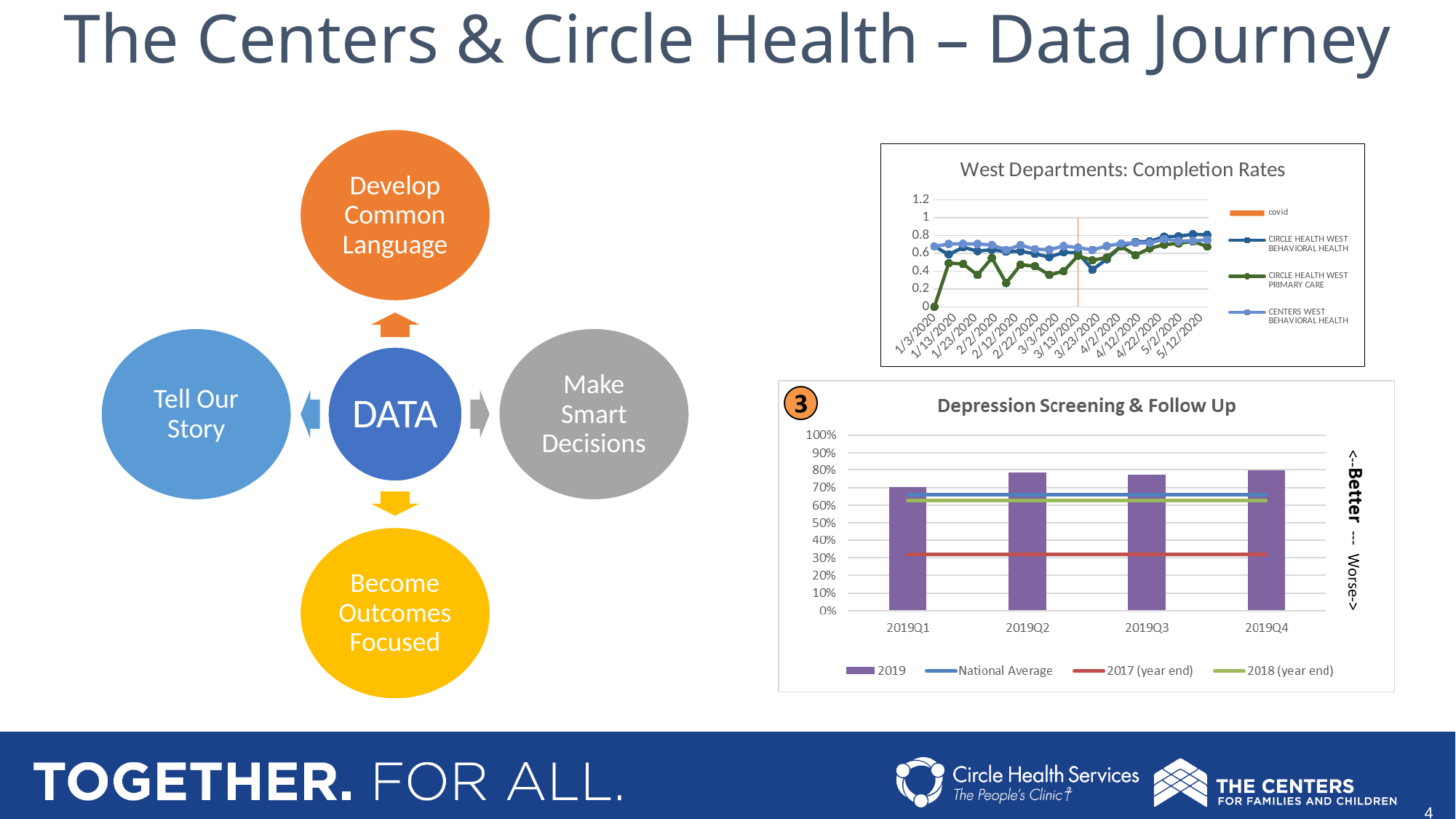
In the 'Depression Screening & Follow Up' chart, what colour are the 2019 bars? purple In the 'West Departments: Completion Rates' chart, what is the value for Circle Health West Primary Care on 1/3/2020? 0 In the 'Depression Screening & Follow Up' chart, how many quarters are shown on the x axis? 4 In the 'Depression Screening & Follow Up' chart, how many entries does the legend list? 4 In the 'West Departments: Completion Rates' chart, how many entries does the legend list? 4 In the 'Depression Screening & Follow Up' chart, is the 2019 bar for 2019Q4 greater or less than 70%? greater In the 'Depression Screening & Follow Up' chart, which is larger: the 2019 bar for 2019Q2 or the 2019 bar for 2019Q1? 2019Q2 In the 'Depression Screening & Follow Up' chart, is the 2017 (year end) line greater or less than 40%? less What kind of chart is the 'Depression Screening & Follow Up' chart? bar chart In the 'Depression Screening & Follow Up' chart, which quarter has the highest 2019 bar? 2019Q4 What kind of chart is the 'West Departments: Completion Rates' chart? line chart In the 'Depression Screening & Follow Up' chart, which quarter has the lowest 2019 bar? 2019Q1